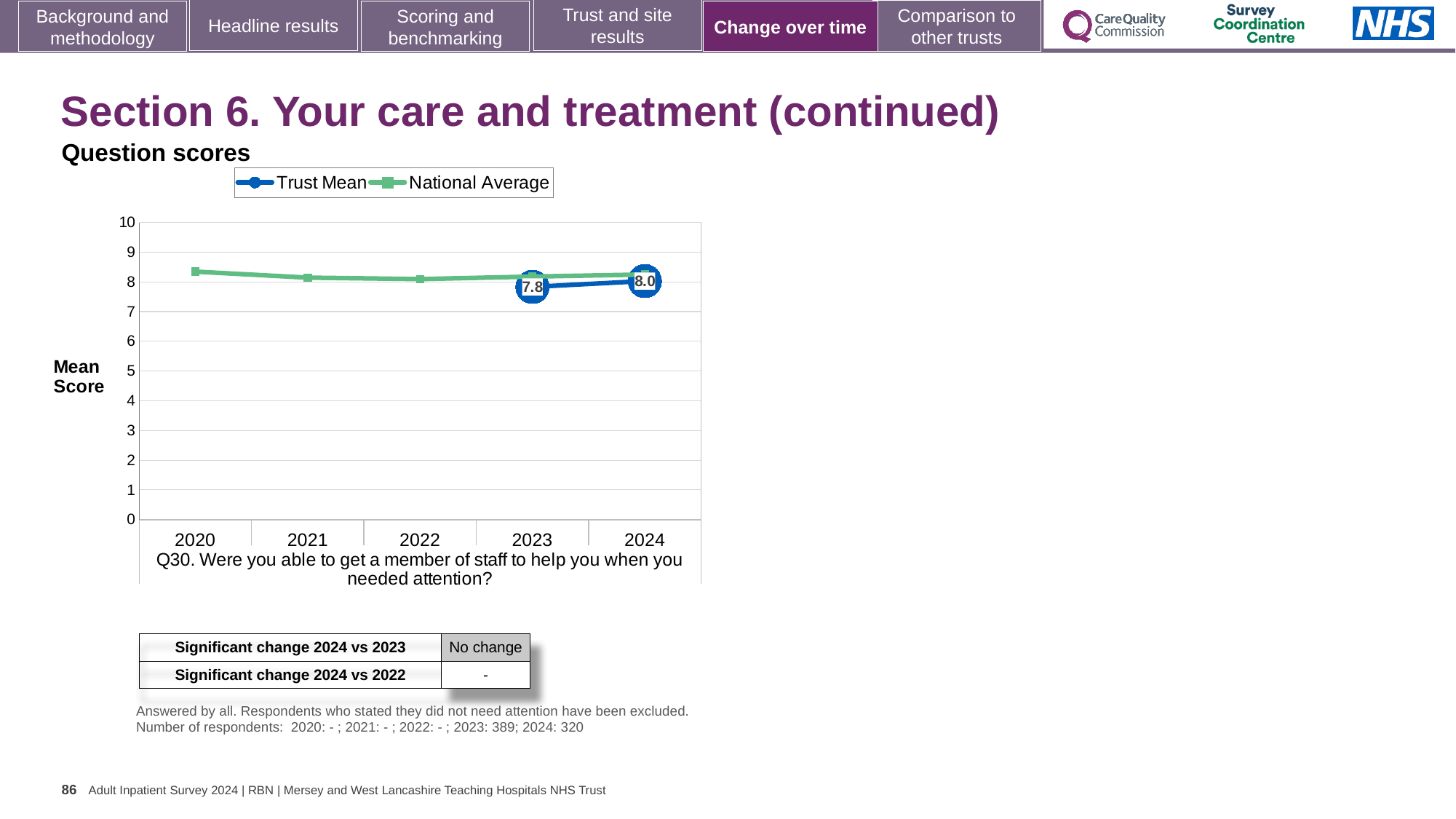
In which year is the Trust Mean highest? 2024 What kind of chart is shown on the slide? Line chart Is the National Average value for 2020 greater or less than 8? greater What is the difference between the Trust Mean values for 2024 and 2023? 0.2 In 2023, which is larger: the Trust Mean or the National Average? National Average What is the label on the y axis of the chart? Mean Score What is the Trust Mean value for 2023? 7.8 How many series does the legend list? 2 What is the Trust Mean value for 2024? 8.0 Does the Trust Mean rise or fall from 2023 to 2024? Rise How many years are shown on the x axis? 5 Is the National Average value for 2021 greater or less than 7? greater